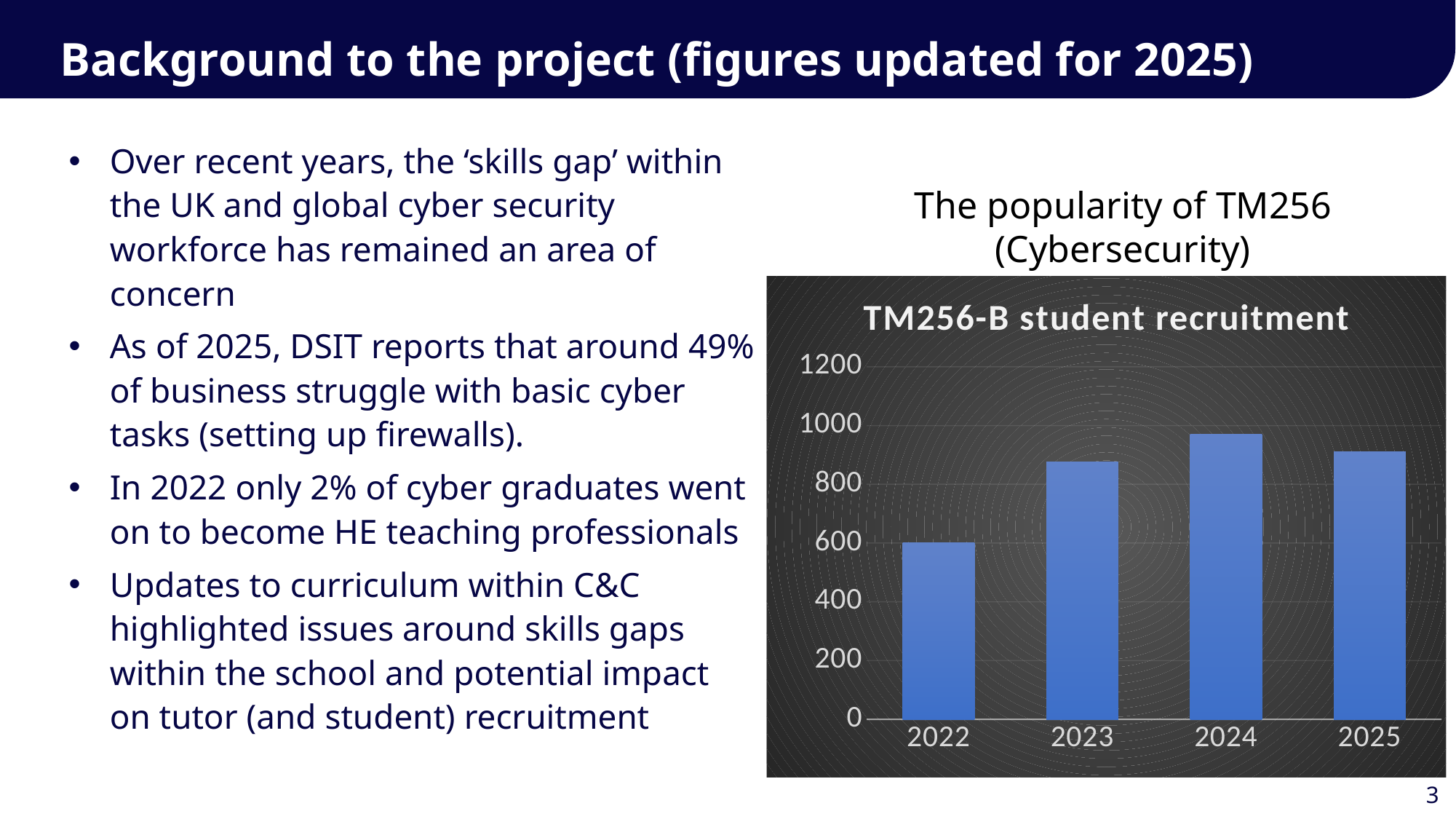
Which year has the lowest student recruitment? 2022 Is the value for 2024 greater or less than 800? greater What is the title of the chart? TM256-B student recruitment What colour are the bars in the chart? Blue Is the value for 2022 greater or less than 800? less Which year has the highest student recruitment? 2024 What type of chart is shown on the slide? Bar chart How many years are shown on the x axis of the chart? 4 Does student recruitment rise or fall from 2022 to 2024? rise Which is larger, the value for 2022 or the value for 2024? 2024 Is the value for 2023 greater or less than 600? greater